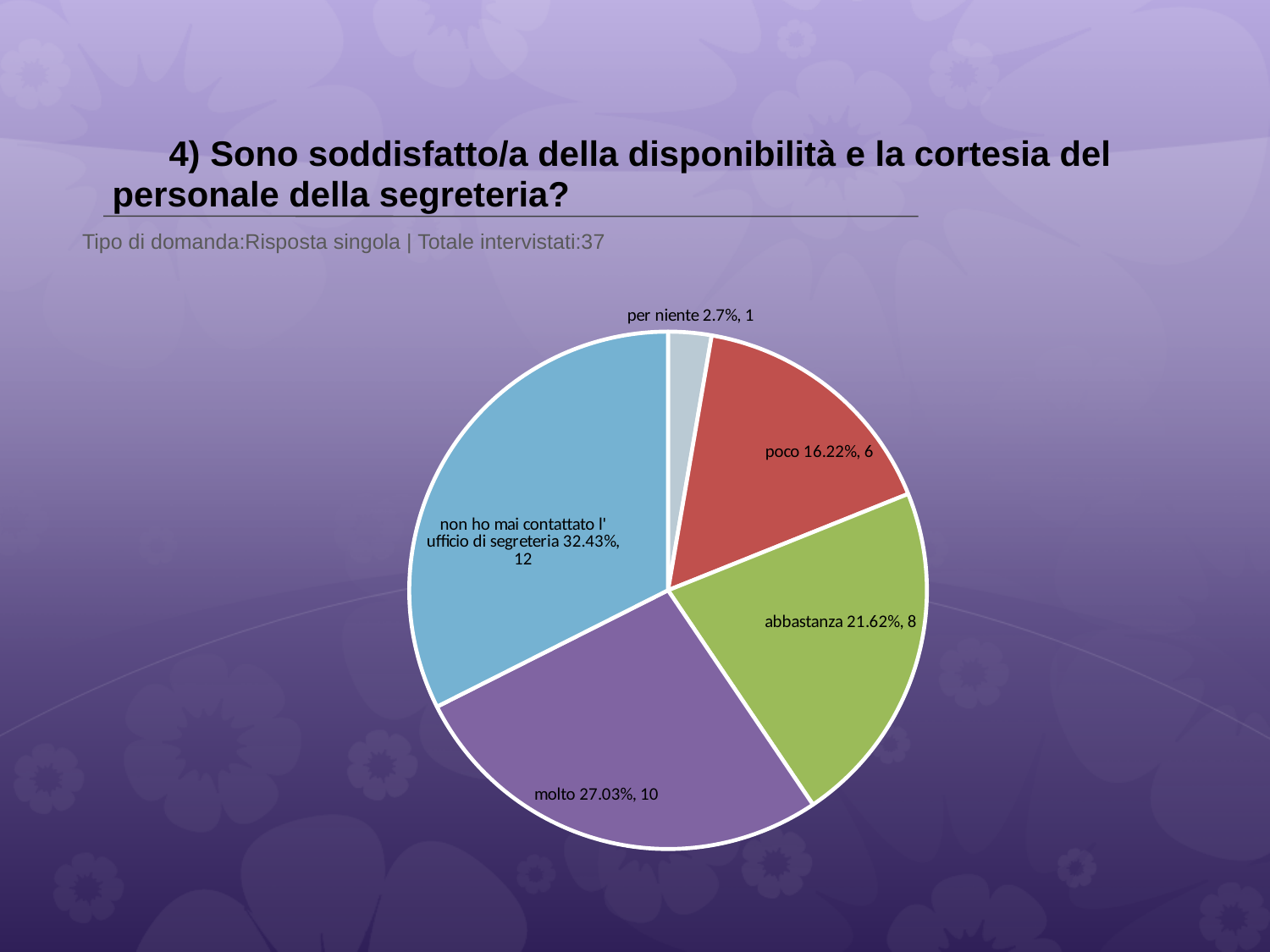
Which category has the smallest slice of the pie? per niente Which has more respondents, 'abbastanza' or 'poco'? abbastanza How many slices does the pie chart have? 5 How many respondents answered 'per niente'? 1 Which category has the largest slice of the pie? non ho mai contattato l' ufficio di segreteria What is the difference in number of respondents between 'molto' and 'poco'? 4 What percentage share does the 'molto' slice have? 27.03% What is the total number of respondents stated on the slide? 37 What colour is the 'molto' slice? purple What percentage share does the 'poco' slice have? 16.22% What kind of chart is shown on the slide? pie chart How many respondents answered 'abbastanza'? 8